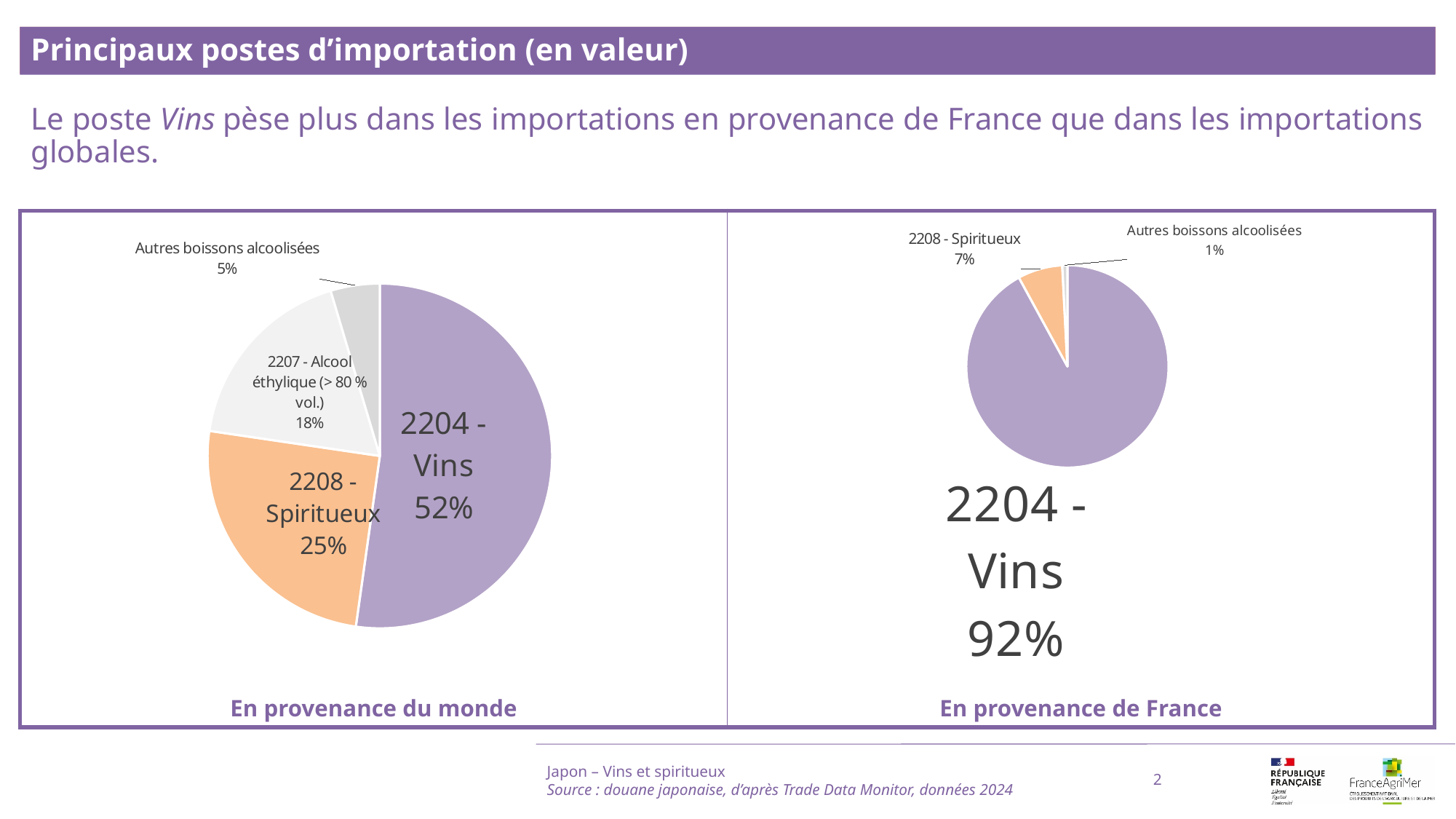
In the 'En provenance de France' pie chart, what share does 2204 - Vins have? 92% In the 'En provenance du monde' pie chart, what share does 2204 - Vins have? 52% In the 'En provenance du monde' pie chart, what share does 2208 - Spiritueux have? 25% In the 'En provenance du monde' pie chart, which category has the largest share? 2204 - Vins In the 'En provenance du monde' pie chart, which category has the smallest share? Autres boissons alcoolisées How many categories are shown in the 'En provenance du monde' pie chart? 4 What is the difference in percentage points between the share of 2204 - Vins in the 'En provenance de France' chart and in the 'En provenance du monde' chart? 40 percentage points What type of chart is used on this slide? Pie chart